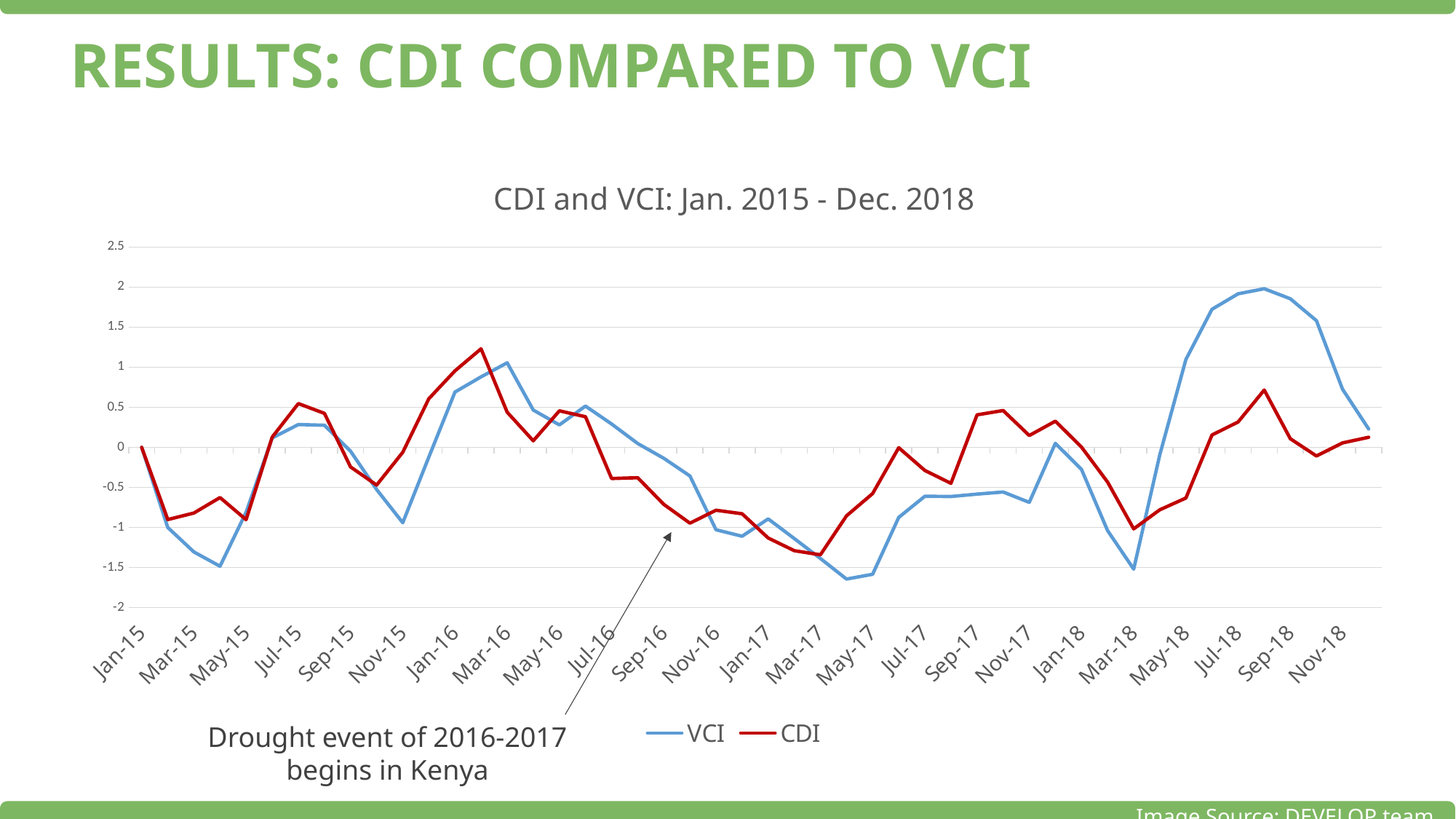
How many month labels are shown on the x axis? 24 Which series reaches the lowest value on the chart? VCI Which series reaches the highest value on the chart? VCI Does the VCI line rise or fall between Mar-18 and Jul-18? Rise At Jul-18, which series has the larger value, VCI or CDI? VCI What kind of chart is shown on the slide? Line chart What is the title of the chart? CDI and VCI: Jan. 2015 - Dec. 2018 Is the value for VCI at Nov-15 greater or less than -0.5? less Is the value for VCI at Jul-18 greater or less than 1.5? greater Is the value for CDI at Mar-17 greater or less than -1? less How many series does the legend list? 2 Which colour is used for the CDI line? Red